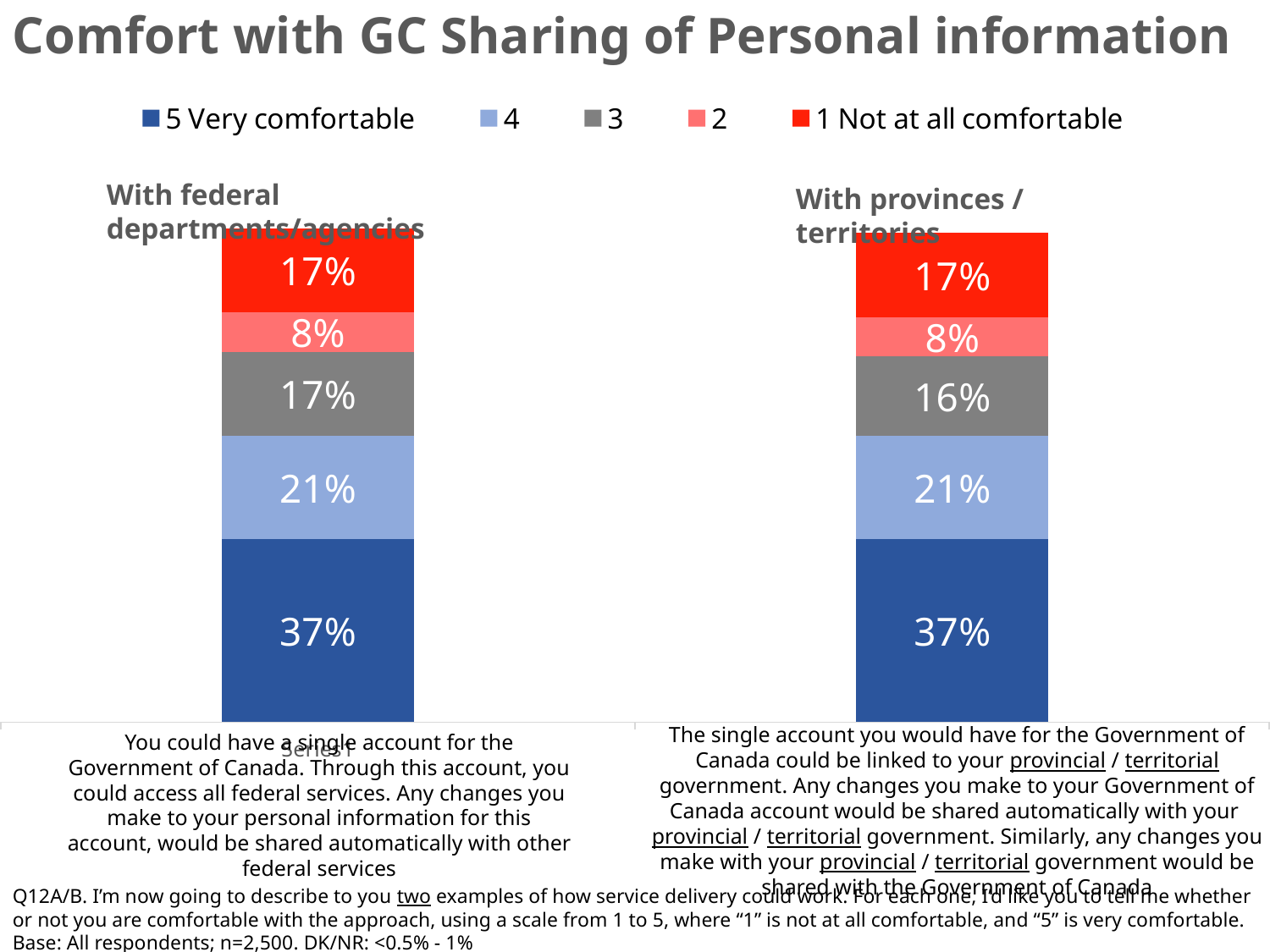
In the 'With federal departments/agencies' chart, what percentage of respondents answered '5 Very comfortable'? 37% What kind of chart is used on this slide? stacked bar chart In the 'With federal departments/agencies' chart, which response category has the largest share? 5 Very comfortable In the 'With provinces / territories' chart, which response category has the smallest share? 2 In the 'With federal departments/agencies' chart, what percentage of respondents answered '1 Not at all comfortable'? 17% In the 'With provinces / territories' chart, what percentage of respondents answered '3'? 16% In the 'With provinces / territories' chart, is the share for '3' larger or smaller than the share for '1 Not at all comfortable'? smaller How many series does the legend list? 5 In the 'With federal departments/agencies' chart, what is the difference between the '5 Very comfortable' share and the '4' share? 16% In the 'With provinces / territories' chart, what is the total of all the segments in the stacked bar? 99% In the 'With provinces / territories' chart, what percentage of respondents answered '4'? 21% Which colour represents '1 Not at all comfortable' in the legend? red